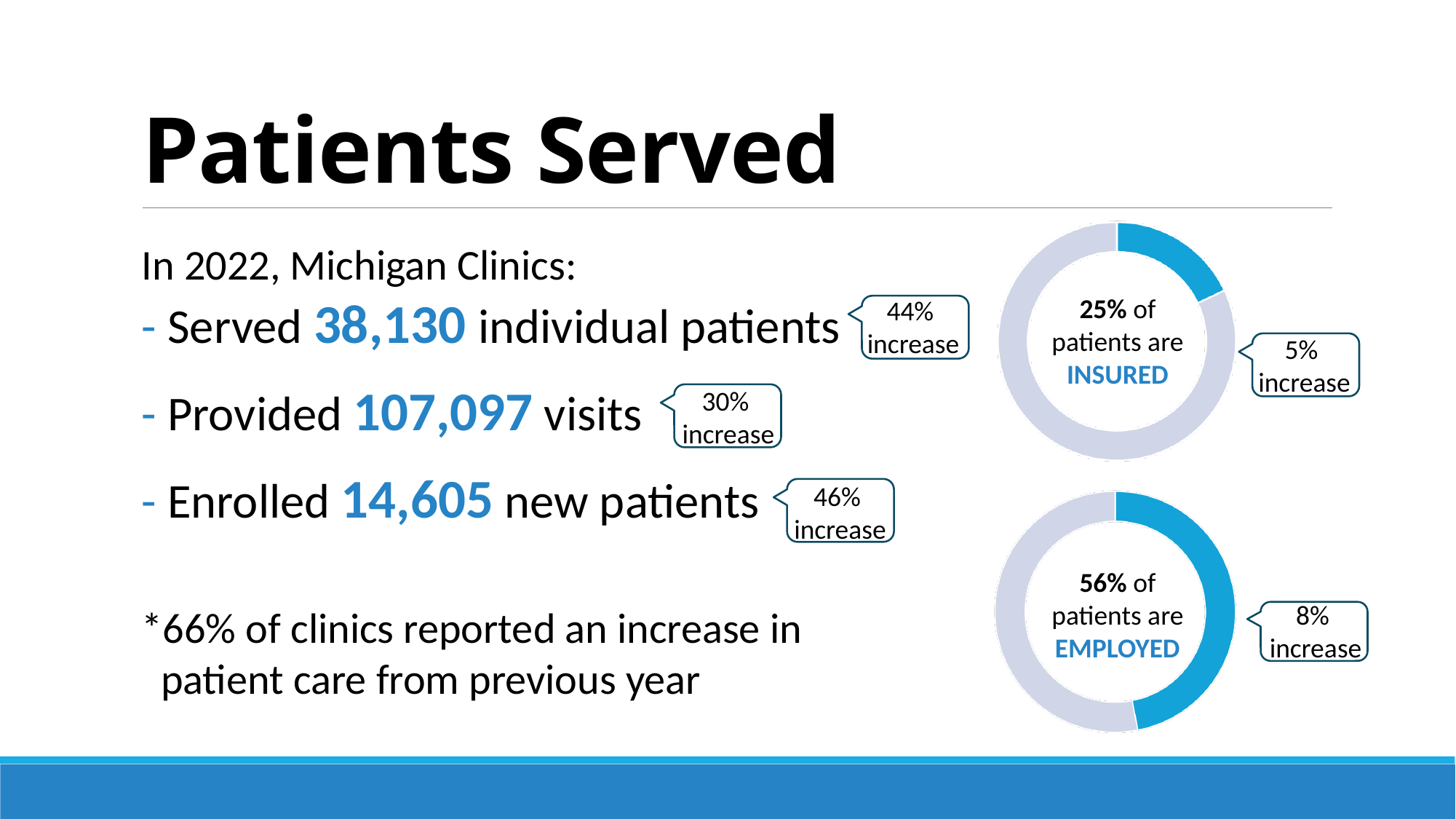
In the bottom donut chart, is the highlighted (blue) share of employed patients greater or less than 50%? greater According to the callout next to the top donut chart, by how much did the share of insured patients increase? 5% increase In the bottom donut chart, what percentage of patients are employed? 56% In the top donut chart, is the highlighted (blue) share of insured patients greater or less than 50%? less How many donut charts are shown on the slide? 2 What kind of chart is used to show the share of patients who are insured? Donut (pie) chart Which donut chart shows the larger increase in its callout, the insured chart or the employed chart? Employed chart In the top donut chart, what percentage of patients are insured? 25% According to the callout next to the bottom donut chart, by how much did the share of employed patients increase? 8% increase By how many percentage points does the share of employed patients exceed the share of insured patients? 31 percentage points Which is larger: the share of patients who are employed or the share who are insured? Employed What colour is used for the highlighted segment in both donut charts? Blue